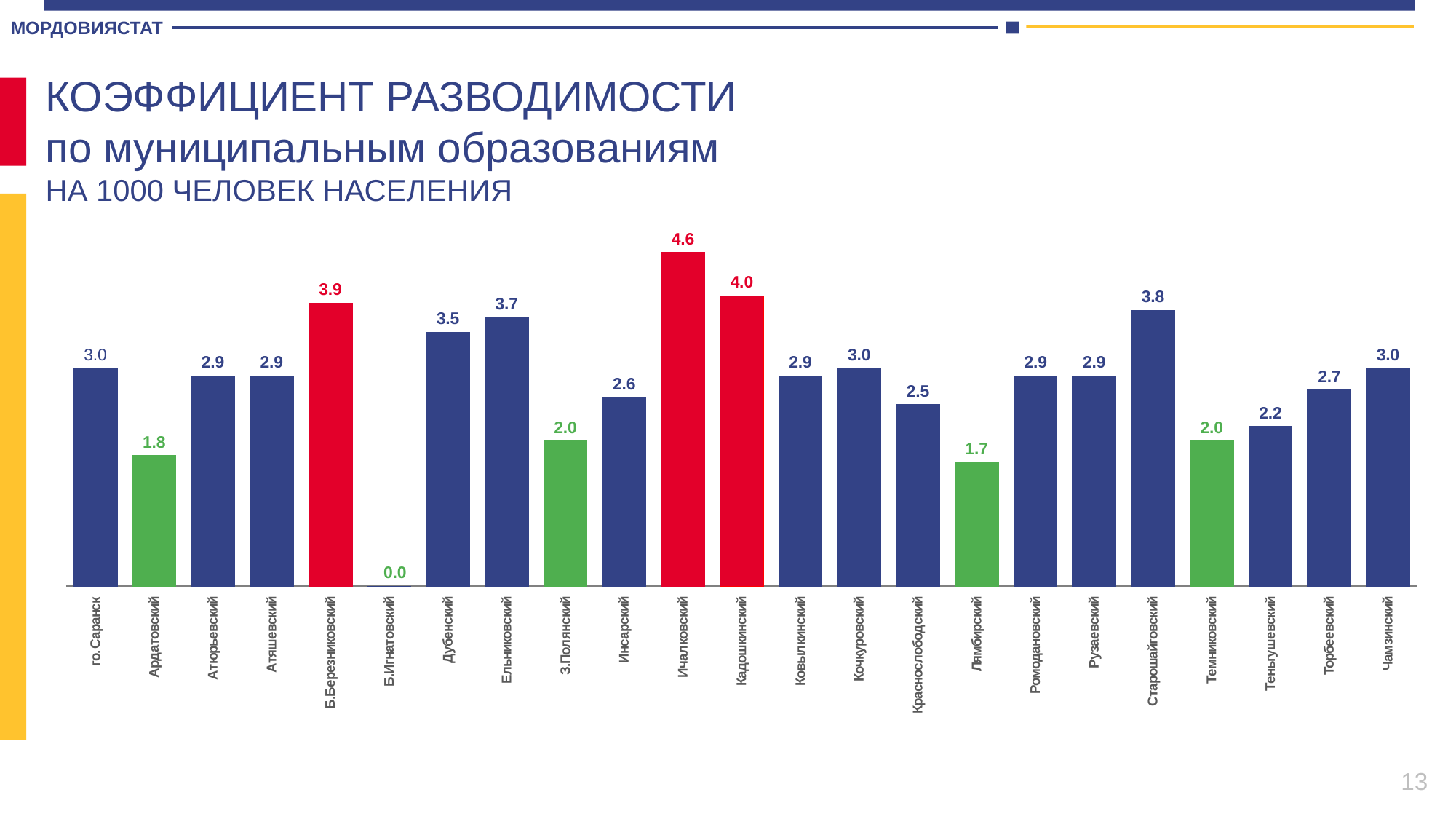
What value is shown for Лямбирский? 1.7 Which municipality has the lowest value on the chart? Б.Игнатовский How many municipalities are shown on the chart? 23 Which has a larger value, Дубенский or Ельниковский? Ельниковский What value is shown for Б.Игнатовский? 0.0 What colour are the bars for Ичалковский and Кадошкинский? Red What type of chart is shown on the slide? Bar chart What is the difference between the values for Ичалковский and Кадошкинский? 0.6 Which municipality has the highest value on the chart? Ичалковский What is the divorce rate value shown for Ичалковский? 4.6 What is the difference between the values for Б.Березниковский and Ардатовский? 2.1 What value is shown for Старошайговский? 3.8